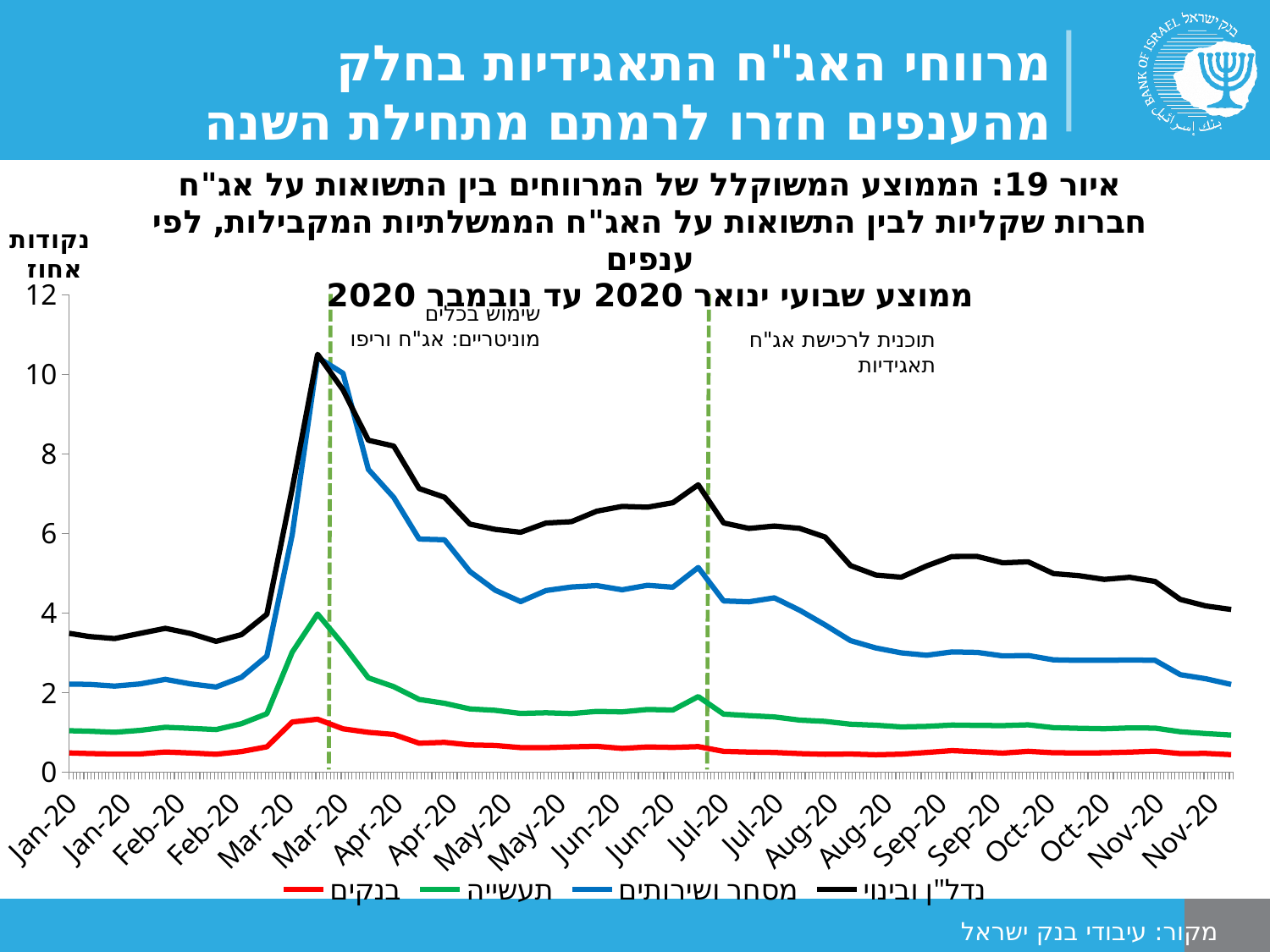
Which series reaches the highest value on the chart? נדל"ן ובינוי Do the values of the נדל"ן ובינוי series rise or fall between April 2020 and November 2020? fall Is the peak value of the תעשייה series in March 2020 greater or less than 6? less Is the peak value of the נדל"ן ובינוי series in March 2020 greater or less than 10? greater What kind of chart is shown on the slide? line chart Is the value of the בנקים series at its March 2020 peak greater or less than 2? less At the end of the chart (Nov-20), which series is higher: מסחר ושירותים or תעשייה? מסחר ושירותים Which series has the lowest values throughout the chart? בנקים What is the maximum value shown on the vertical axis? 12 How many series does the legend list? 4 What colour is the line for the בנקים series? red